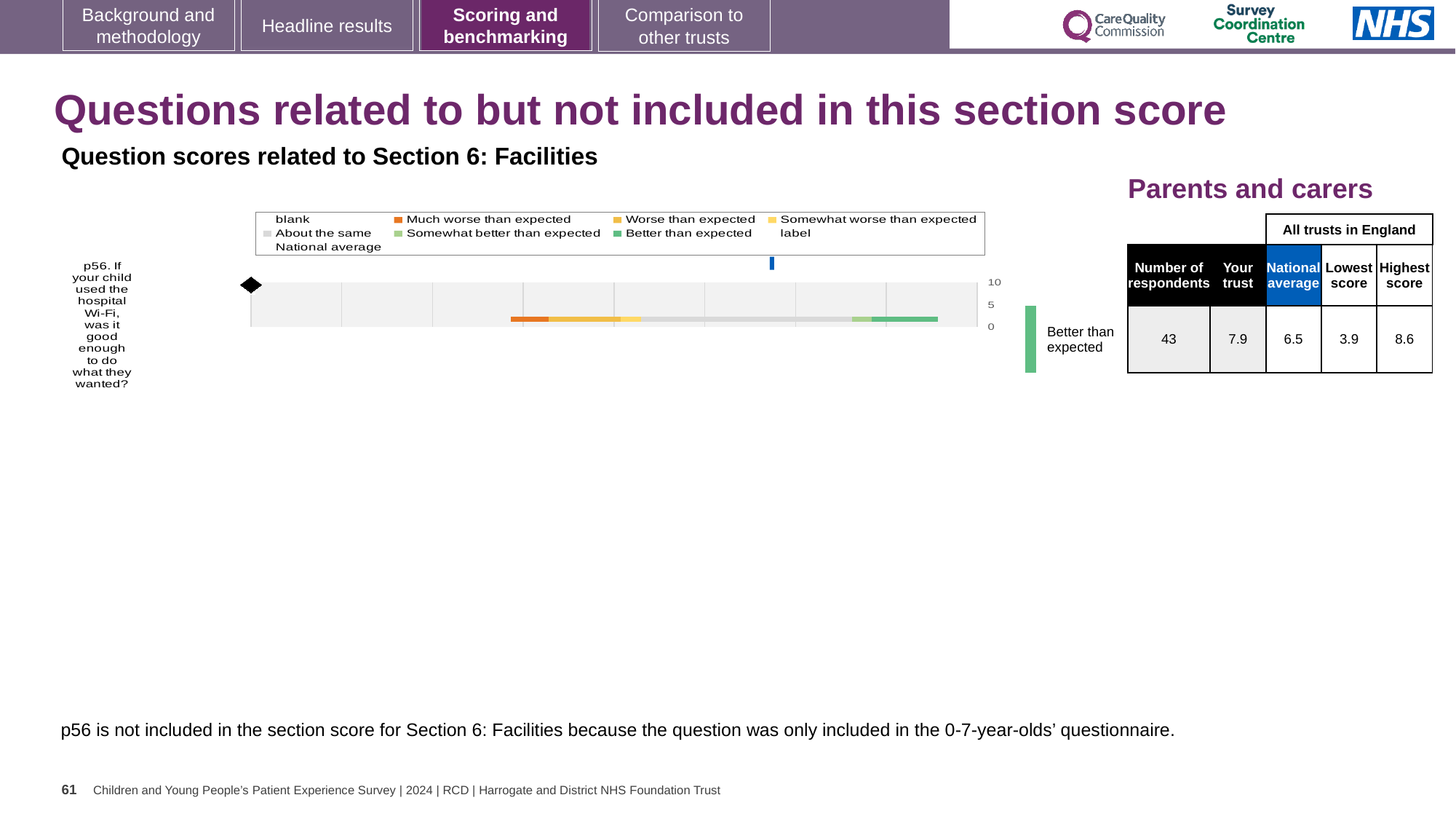
What is the difference between the 'Your trust' score and the national average for p56? 1.4 How many questions are plotted in the chart? 1 What is the highest value shown on the chart's score axis? 10 Which is larger for p56, the 'Your trust' score or the national average? Your trust What is the difference between the highest and lowest scores among all trusts in England for p56? 4.7 What is the highest score among all trusts in England for p56? 8.6 What is the 'Your trust' score for p56? 7.9 What is the national average score for p56? 6.5 How many respondents answered p56? 43 What benchmark category label is shown next to the p56 bar? Better than expected What is the lowest score among all trusts in England for p56? 3.9 What kind of chart is used to show the p56 question score? Bar chart